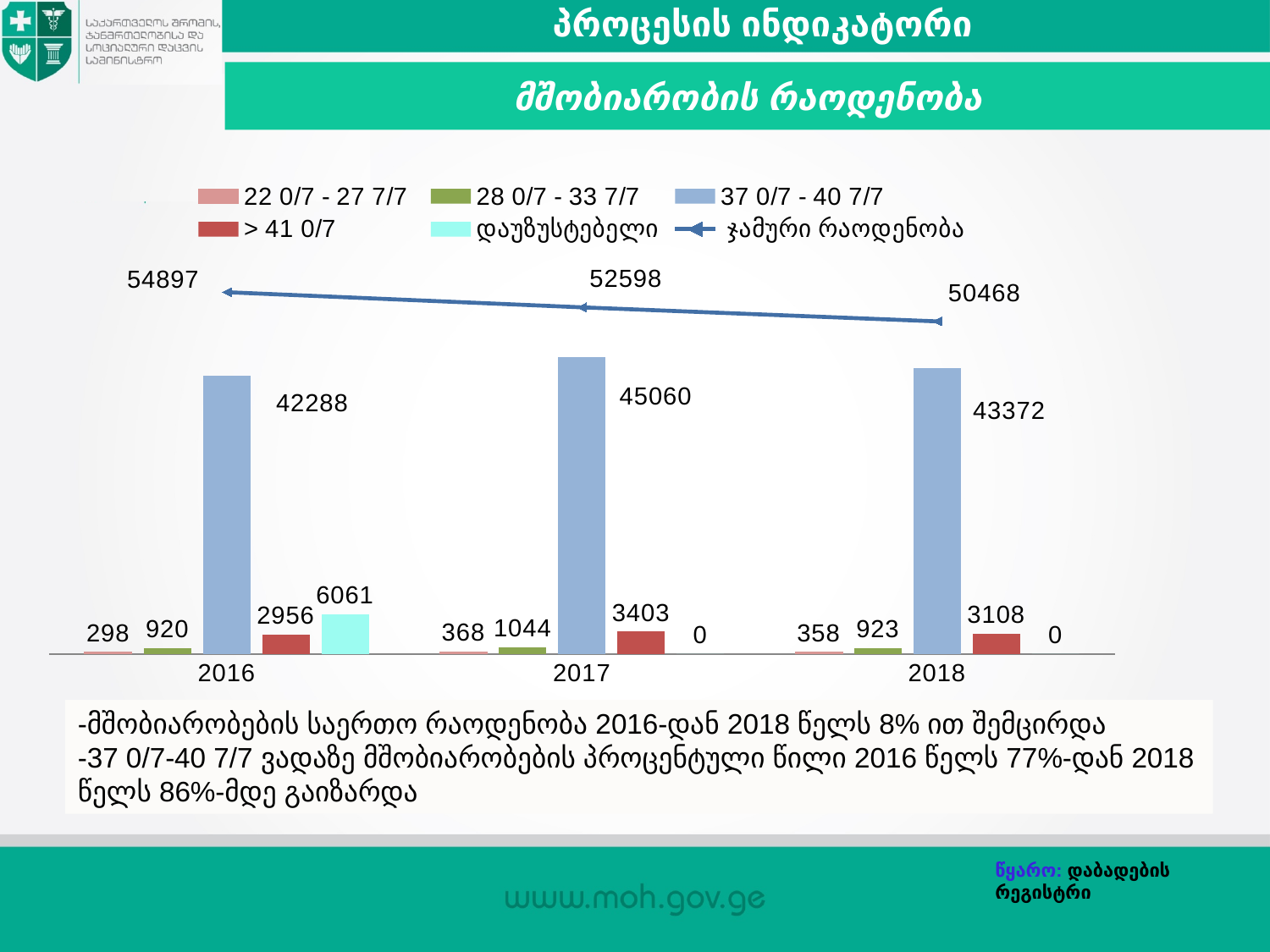
What is the value of the "> 41 0/7" series for 2016? 2956 What is the total count (ჯამური რაოდენობა) shown for 2018? 50468 What is the value of the "22 0/7 - 27 7/7" series for 2018? 358 What is the value of the "დაუზუსტებელი" series for 2016? 6061 Does the total count (ჯამური რაოდენობა) line rise or fall from 2016 to 2018? fall Is the "> 41 0/7" value larger in 2017 or in 2018? 2017 What is the difference between the total count for 2016 and the total count for 2018? 4429 Which year has the lowest value for the "28 0/7 - 33 7/7" series? 2016 What is the value of the "37 0/7 - 40 7/7" series for 2017? 45060 Which year has the highest total count (ჯამური რაოდენობა)? 2016 How many series does the legend list? 6 How many years are shown on the x axis? 3